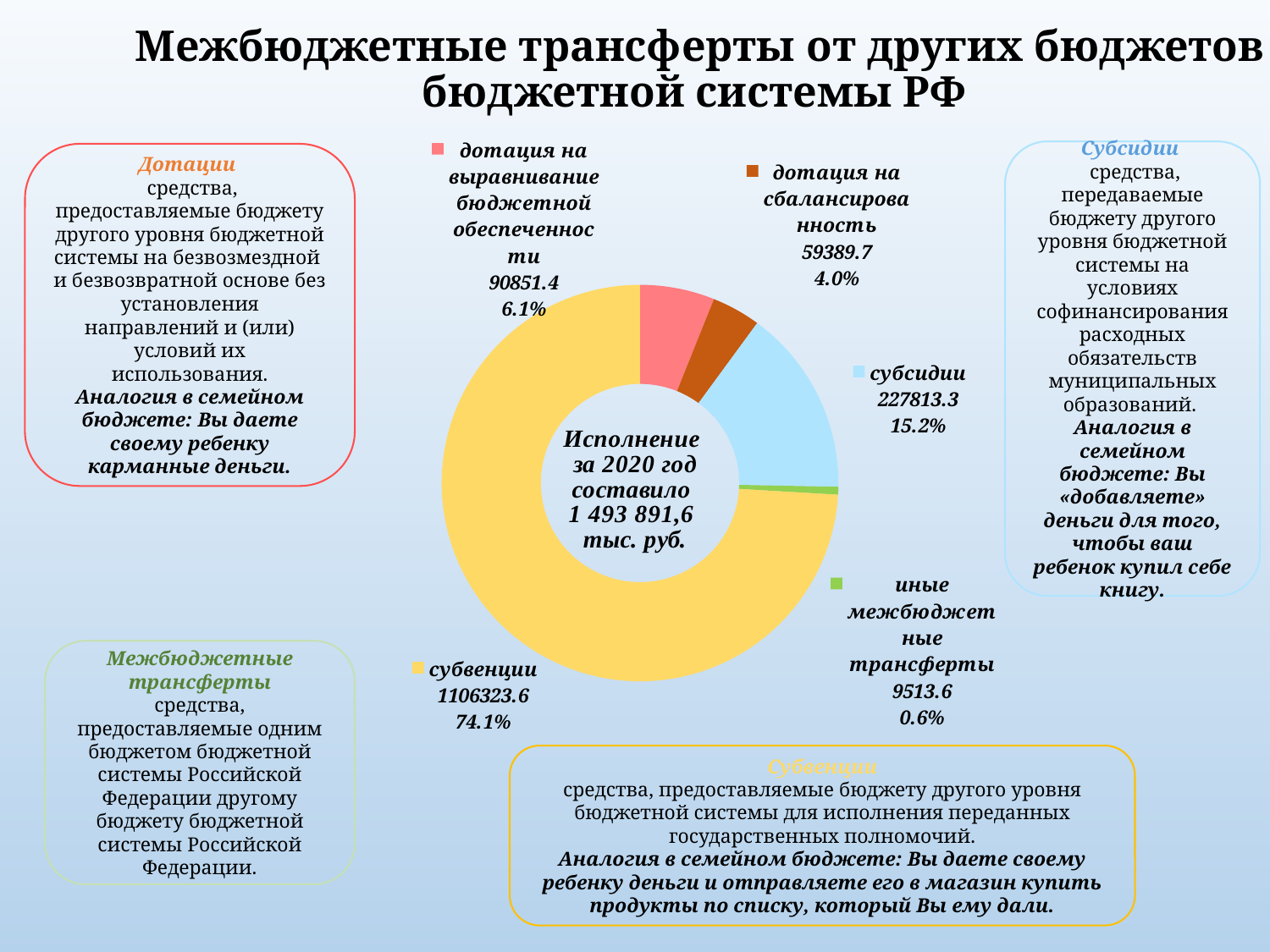
What value is shown for субвенции in the chart? 1106323.6 Which category has the largest share of the chart? субвенции What percentage share does субсидии have in the chart? 15.2% What value is shown for дотация на сбалансированность? 59389.7 What kind of chart is shown on the slide? pie (doughnut) chart What percentage share is shown for иные межбюджетные трансферты? 0.6% How many categories are shown in the chart? 5 What is the difference between the values for субсидии and дотация на сбалансированность? 168423.6 Which category has the smallest share of the chart? иные межбюджетные трансферты What total amount is stated in the centre of the chart for 2020? 1 493 891,6 тыс. руб. What percentage share is shown for дотация на выравнивание бюджетной обеспеченности? 6.1% Which is larger: дотация на выравнивание бюджетной обеспеченности or дотация на сбалансированность? дотация на выравнивание бюджетной обеспеченности